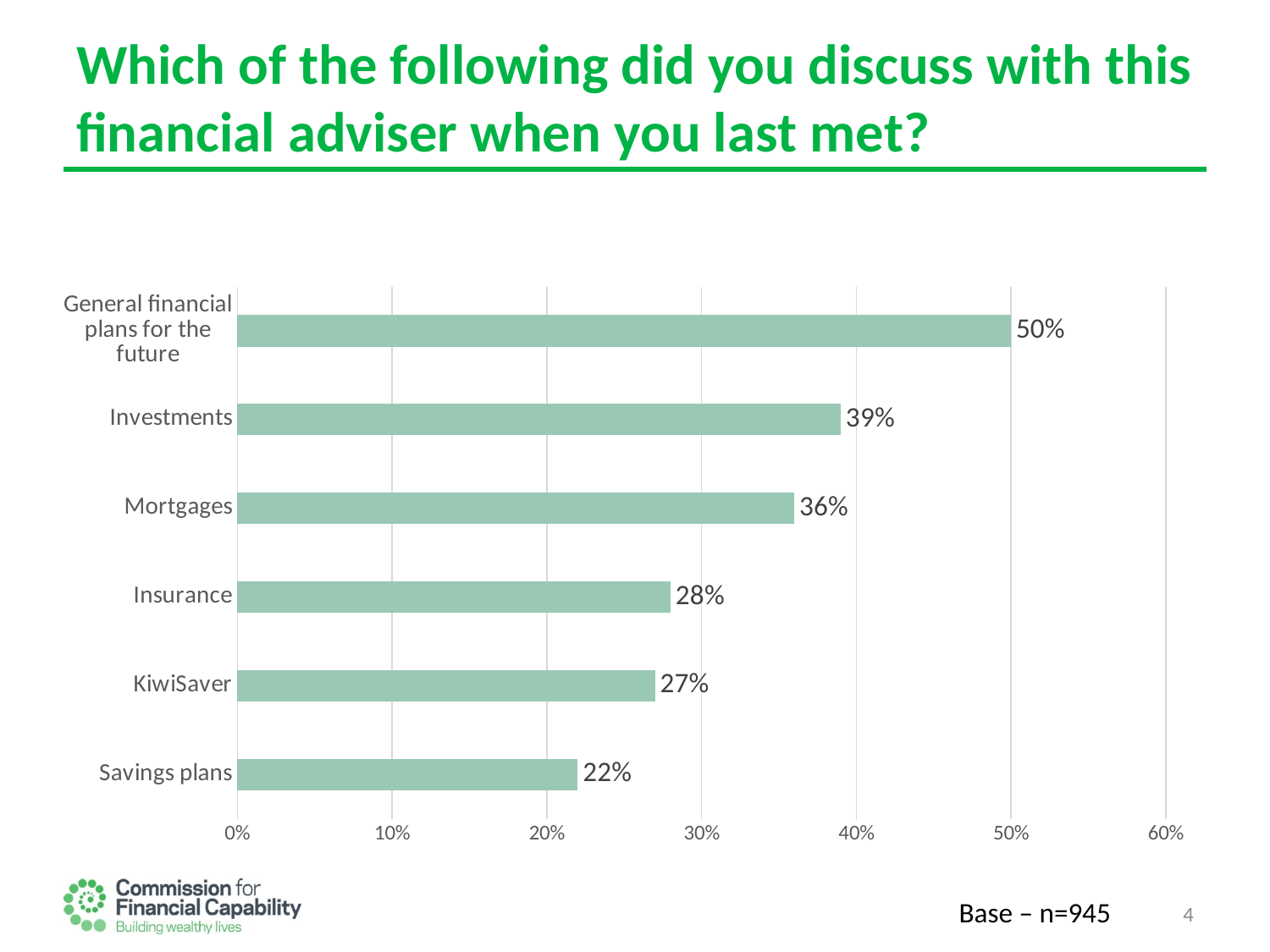
What percentage is shown for KiwiSaver? 27% How many topics (categories) are shown on the chart? 6 What percentage of respondents discussed Investments with their financial adviser? 39% Which has a higher value, Mortgages or KiwiSaver? Mortgages Which topic has the highest percentage on the chart? General financial plans for the future Is the value for Insurance greater or less than 30%? less What is the base sample size noted on the slide? n=945 Which topic has the lowest percentage on the chart? Savings plans What type of chart is shown on the slide? Bar chart What is the difference in percentage points between General financial plans for the future and Investments? 11 What is the value shown for Savings plans? 22% What is the difference in percentage points between Mortgages and Insurance? 8